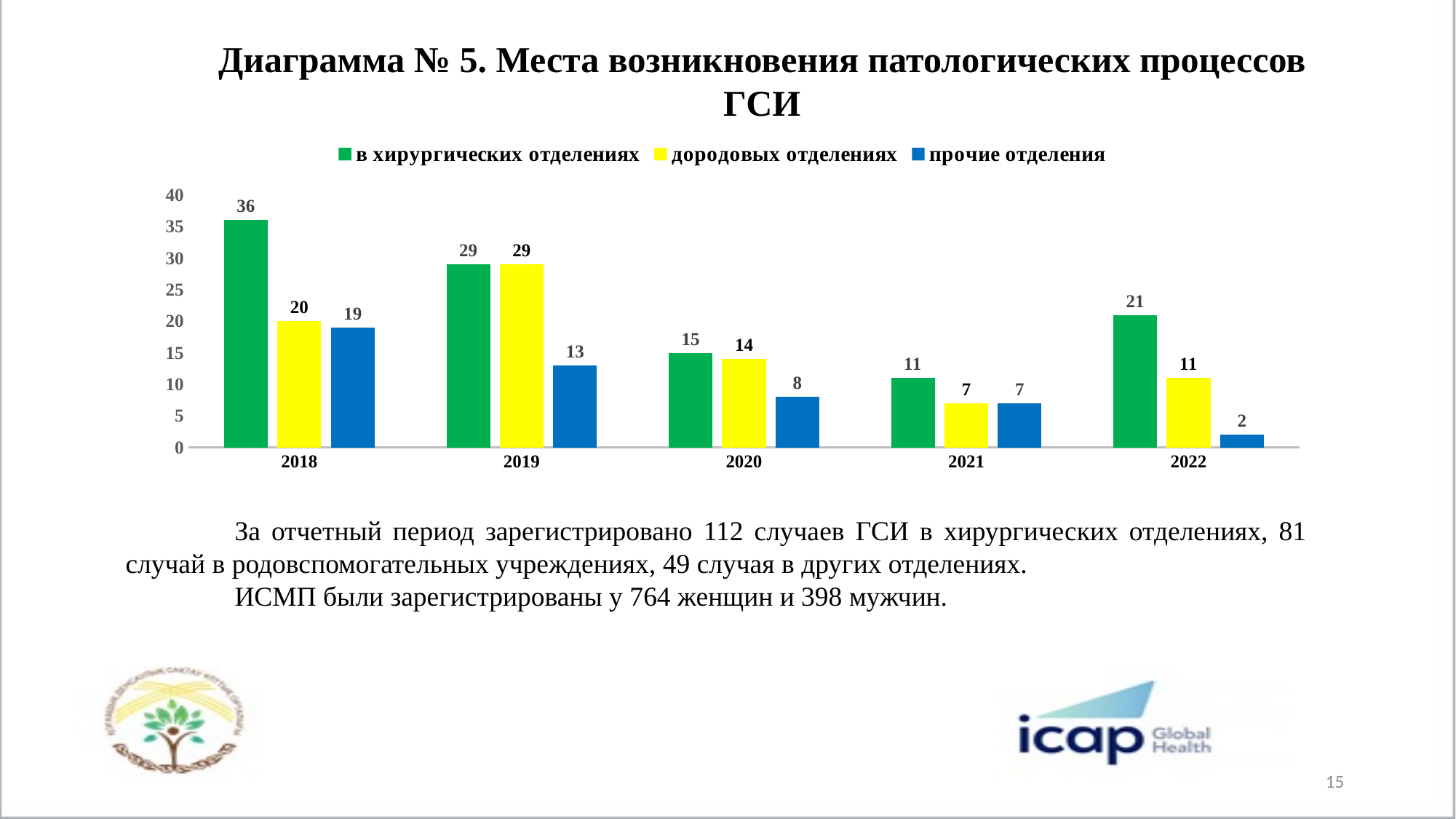
What is the value for "в хирургических отделениях" in 2018? 36 Which colour represents "дородовых отделениях" in the chart? yellow Which is larger in 2022: the value for "в хирургических отделениях" or the value for "дородовых отделениях"? в хирургических отделениях How many series does the legend list? 3 What is the value for "дородовых отделениях" in 2020? 14 In which year is the value for "прочие отделения" lowest? 2022 What is the value for "прочие отделения" in 2022? 2 Does the value for "прочие отделения" rise or fall from 2018 to 2022? fall How many years are shown on the x axis? 5 What is the difference between the "в хирургических отделениях" value and the "дородовых отделениях" value in 2018? 16 What kind of chart is shown on the slide? bar chart In which year is the value for "в хирургических отделениях" highest? 2018